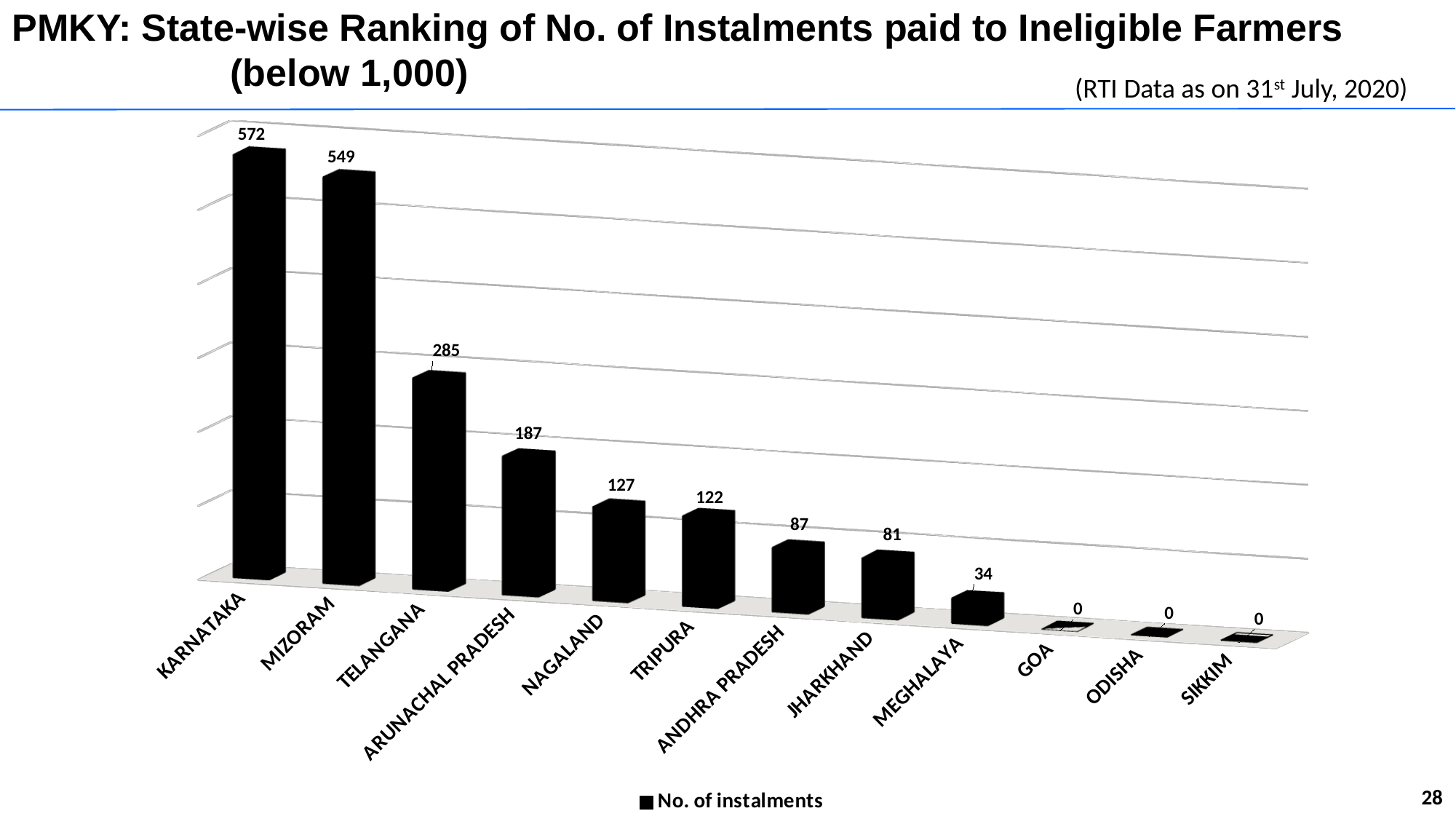
What kind of chart is shown on the slide? Bar chart Which state has the highest number of instalments? Karnataka What series name does the legend show? No. of instalments What is the value shown for Nagaland? 127 How many states have a value of 0? 3 What is the number of instalments for Telangana? 285 What is the difference between the values for Arunachal Pradesh and Jharkhand? 106 Which has a larger value, Tripura or Andhra Pradesh? Tripura What is the value shown for Meghalaya? 34 What is the number of instalments paid to ineligible farmers in Karnataka? 572 What is the difference between the values for Karnataka and Mizoram? 23 How many states are shown on the chart? 12